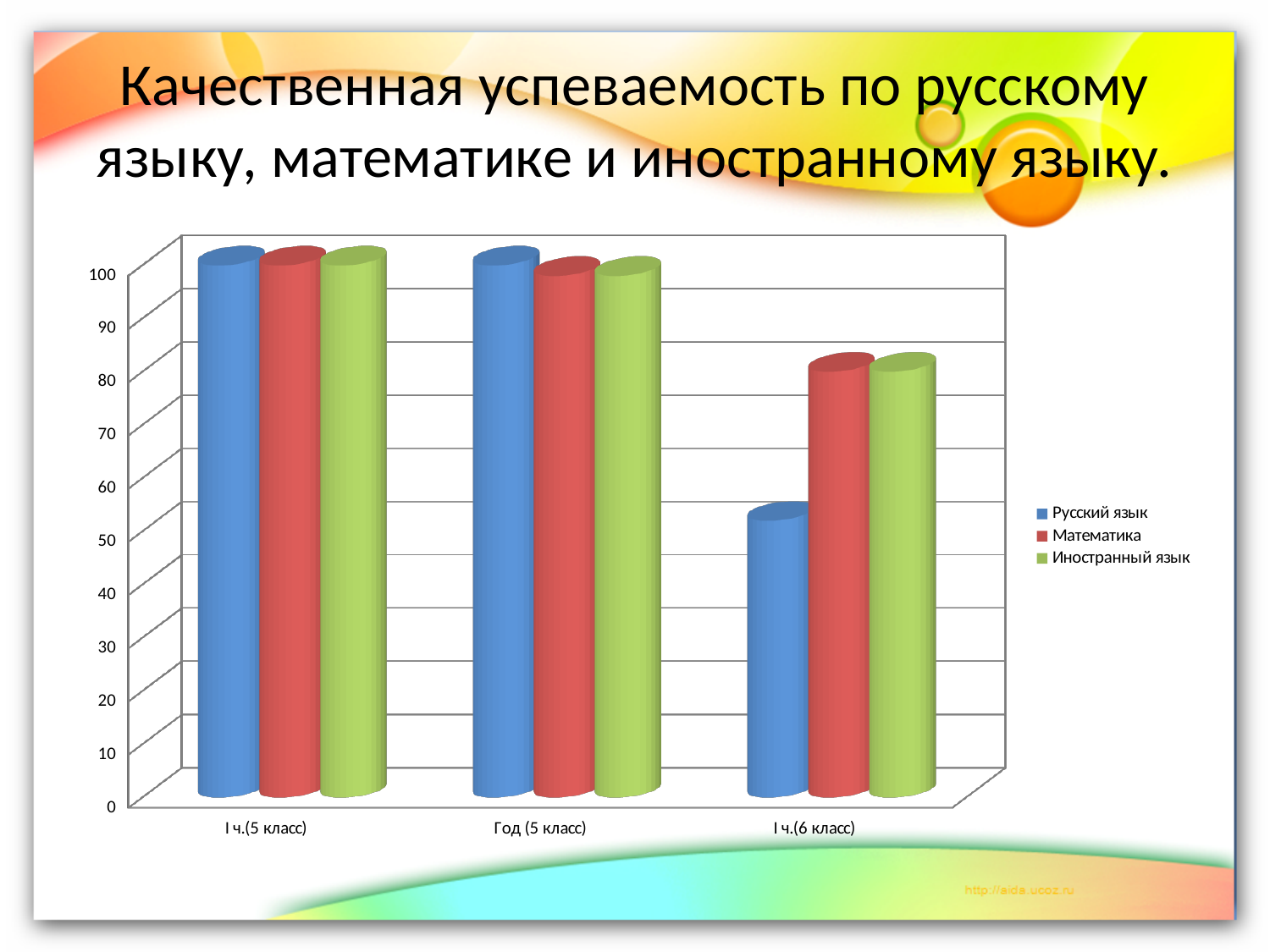
Which series has the lowest value in the I ч.(6 класс) category? Русский язык How many categories are shown on the x axis of the chart? 3 In the I ч.(6 класс) category, which is larger: Русский язык or Математика? Математика Is the value for Математика in I ч.(6 класс) greater or less than 70? greater How many series does the chart's legend list? 3 Is the value for Иностранный язык in I ч.(6 класс) greater or less than 90? less Is the value for Русский язык in I ч.(5 класс) greater or less than 90? greater What is the label of the last category on the x axis? I ч.(6 класс) Which colour represents Математика in the chart's legend? Red Do the values for Русский язык rise or fall from I ч.(5 класс) to I ч.(6 класс)? fall What kind of chart is shown on the slide? Bar chart